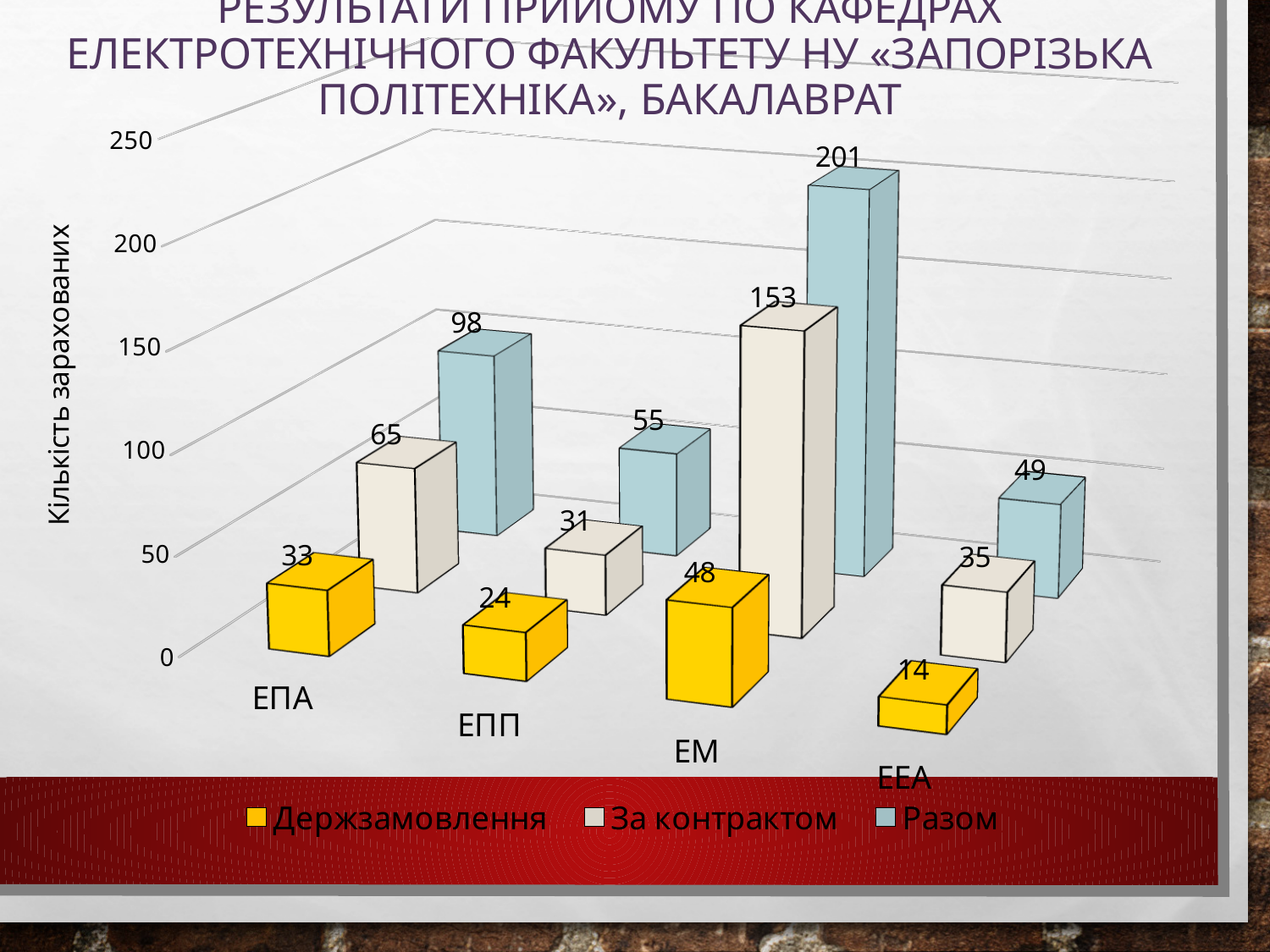
What kind of chart is shown on the slide? bar chart What is the difference between the Разом values for ЕМ and ЕПА? 103 Which is larger: За контрактом for ЕПП or За контрактом for ЕЕА? За контрактом for ЕЕА How many categories are shown on the x axis? 4 What is the value of За контрактом for ЕПА? 65 How many series does the legend list? 3 Is the Разом value for ЕПП greater or less than 50? greater Which category has the highest Разом value? ЕМ What is the value of Разом for ЕЕА? 49 What is the value of Держзамовлення for ЕМ? 48 What is the label of the vertical axis? Кількість зарахованих Which category has the lowest Держзамовлення value? ЕЕА